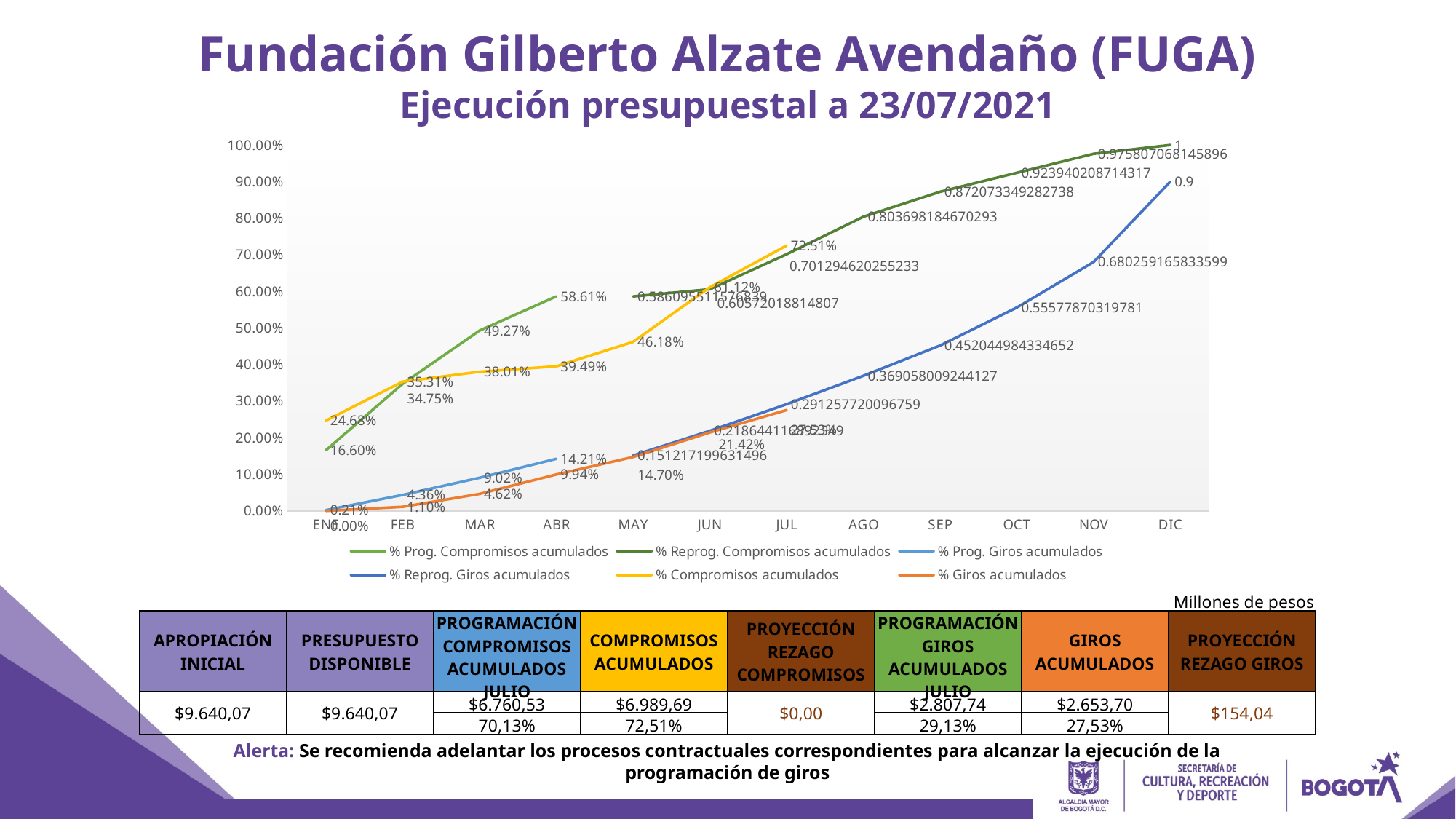
Does the % Reprog. Compromisos acumulados line rise or fall from MAY to DIC? Rise Is the value for % Reprog. Giros acumulados in NOV greater or less than 60%? greater What is the value of % Prog. Compromisos acumulados in ABR? 58.61% How many series does the chart legend list? 6 What type of chart is shown on the slide? Line chart What is the value of % Prog. Giros acumulados in MAR? 9.02% What is the value of % Compromisos acumulados in JUL? 72.51% What is the value of % Giros acumulados in JUL? 27.53% How many months are shown on the x axis of the chart? 12 What is the value of % Reprog. Giros acumulados in DIC? 0.9 What is the difference between % Compromisos acumulados and % Giros acumulados in JUL? 44.98% In ABR, which is larger: % Prog. Compromisos acumulados or % Compromisos acumulados? % Prog. Compromisos acumulados